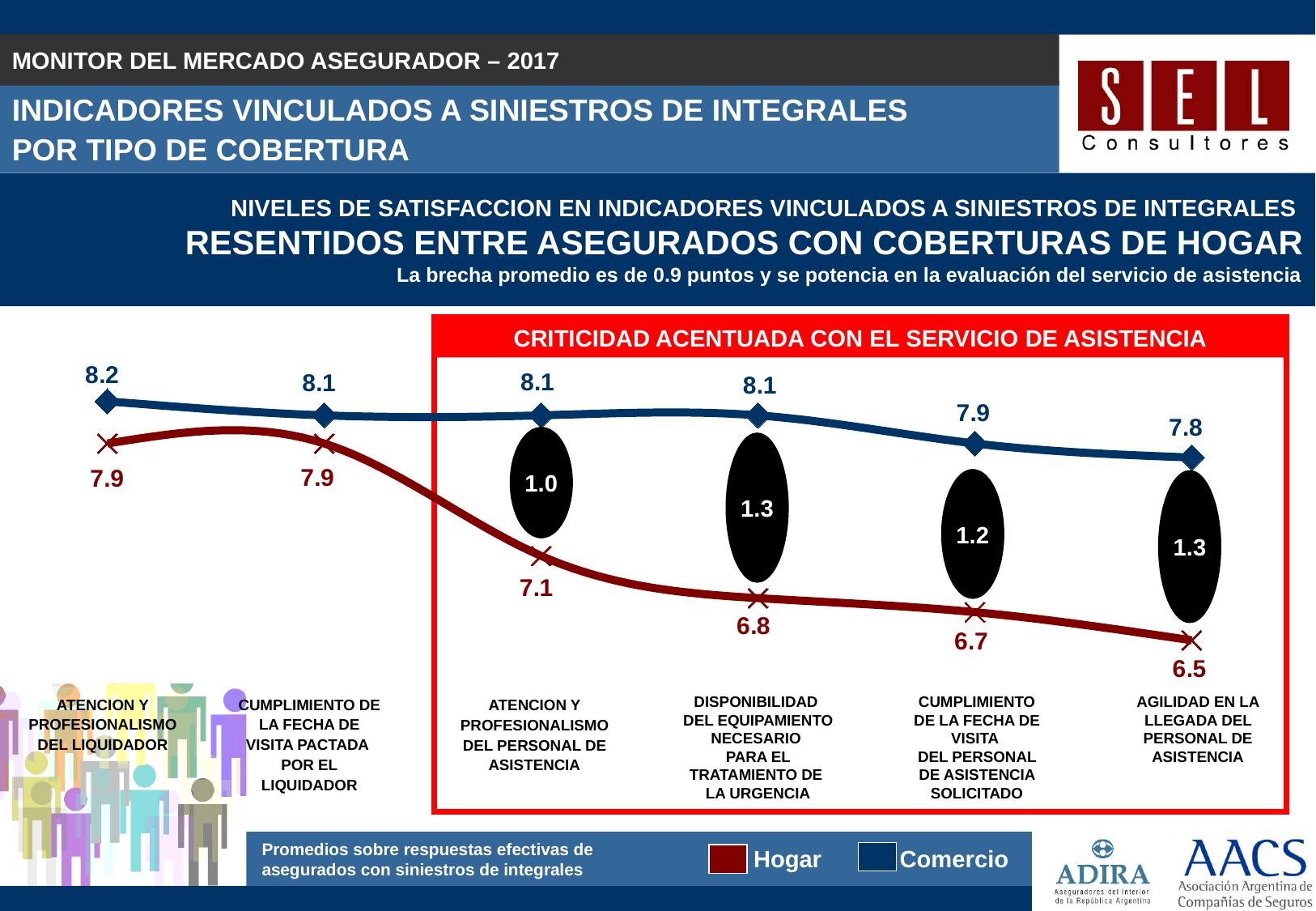
How many series does the legend list? 2 What is the Hogar value for 'Agilidad en la llegada del personal de asistencia'? 6.5 Does the Hogar series rise or fall from left to right across the categories? Fall What is the Hogar value for 'Disponibilidad del equipamiento necesario para el tratamiento de la urgencia'? 6.8 How many categories are plotted on the chart? 6 What is the difference between the Comercio and Hogar values for 'Agilidad en la llegada del personal de asistencia'? 1.3 Which category has the highest Comercio value? Atencion y profesionalismo del liquidador Which category has the lowest Hogar value? Agilidad en la llegada del personal de asistencia Which series has the higher value for 'Cumplimiento de la fecha de visita del personal de asistencia solicitado', Hogar or Comercio? Comercio What is the Comercio value for 'Atencion y profesionalismo del liquidador'? 8.2 What is the Comercio value for 'Cumplimiento de la fecha de visita del personal de asistencia solicitado'? 7.9 What is the difference between the Comercio and Hogar values for 'Atencion y profesionalismo del personal de asistencia'? 1.0